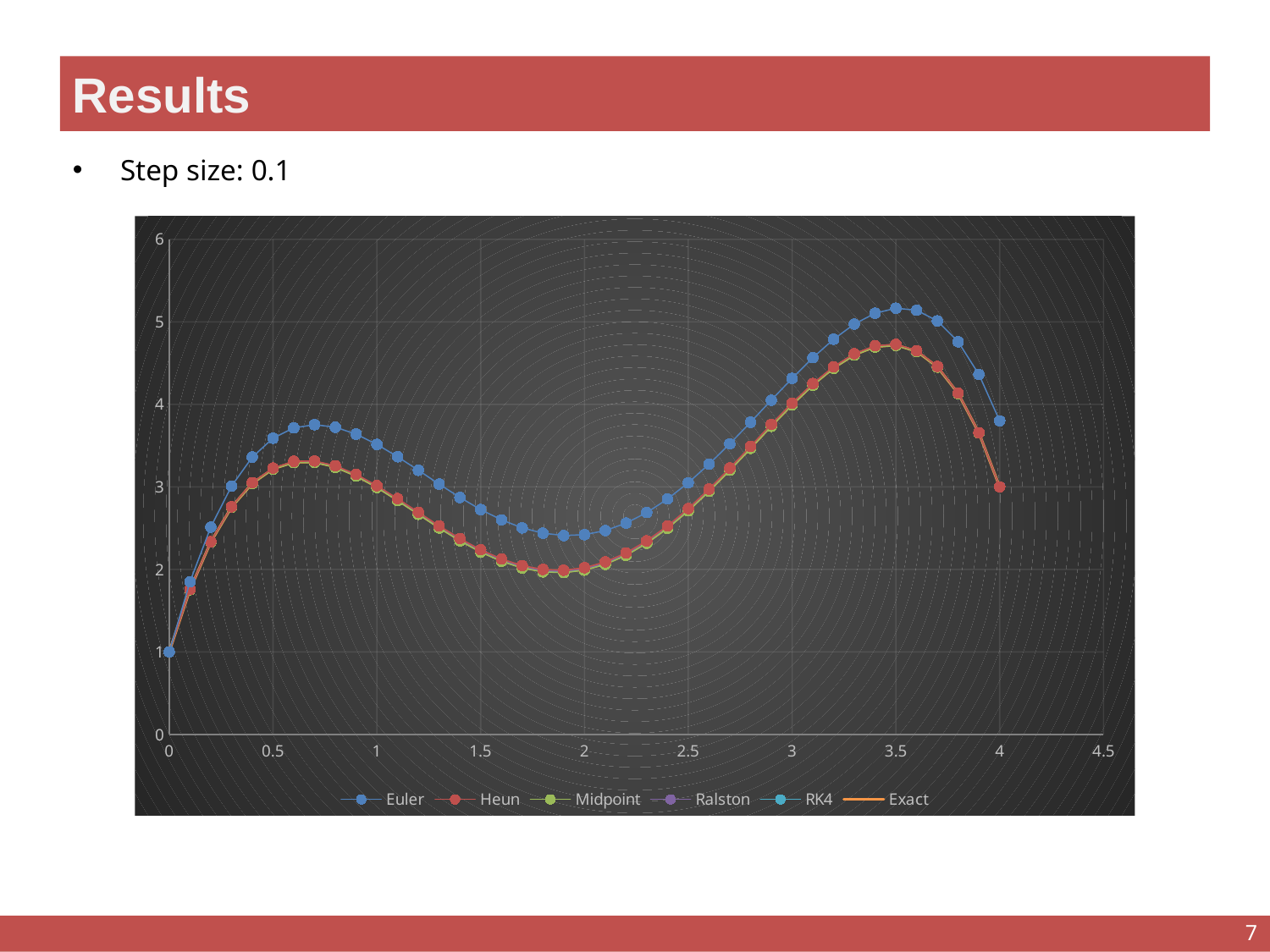
Which series has the highest value at x = 3.5? Euler Is the value of the Euler series at x = 3.5 greater or less than 5? greater How many series does the legend list? 6 What is the highest value shown on the y axis? 6 What is the value of the Euler series at x = 0? 1 Is the value of the Euler series at x = 4 greater or less than 3? greater Is the value of the Heun series at x = 3.5 greater or less than 5? less Which series are listed in the chart legend? Euler, Heun, Midpoint, Ralston, RK4, Exact At x = 3.5, which series has the larger value, Euler or Heun? Euler What kind of chart is shown on the slide? line chart Do the values of the Euler series rise or fall between x = 3.5 and x = 4? fall